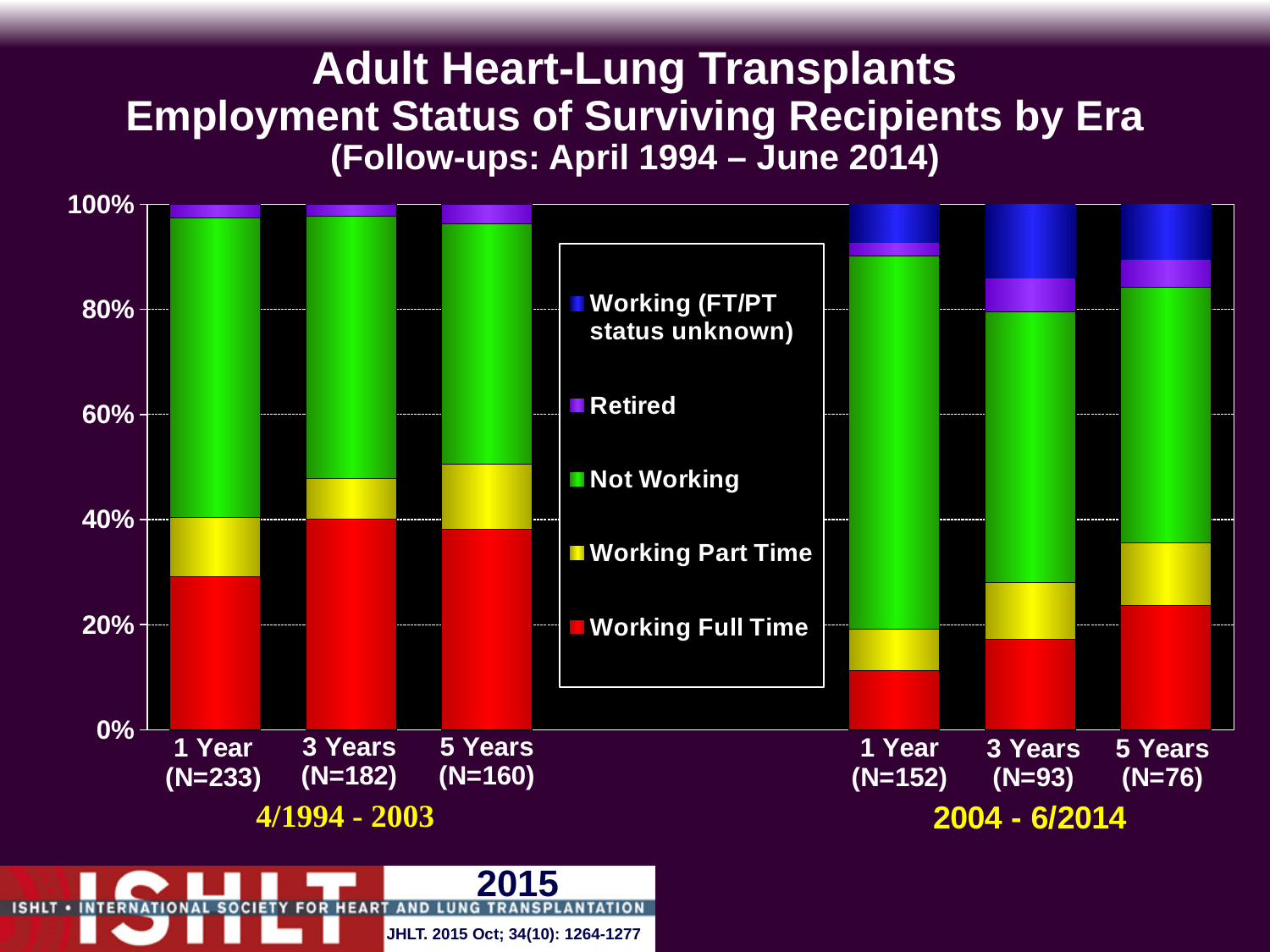
What kind of chart is shown on the slide? Stacked bar chart Is the Working Full Time share for 1 Year (N=233) in the 4/1994 - 2003 era greater or less than 20%? greater Which colour represents Working Full Time in the legend? Red What follow-up period is given in the chart title? April 1994 – June 2014 Which bar has the largest Not Working segment? 1 Year (N=152), 2004 - 6/2014 Which has the larger Working Full Time share: 1 Year (N=233) in 4/1994 - 2003 or 1 Year (N=152) in 2004 - 6/2014? 1 Year (N=233) in 4/1994 - 2003 Is the Working Full Time share for 3 Years (N=93) in the 2004 - 6/2014 era greater or less than 20%? less Is the Working Full Time share for 1 Year (N=152) in the 2004 - 6/2014 era greater or less than 20%? less Which bar has the smallest Working Full Time segment? 1 Year (N=152), 2004 - 6/2014 How many bars are plotted in total across both eras? 6 How many series does the legend list? 5 How many follow-up time points are shown for the 2004 - 6/2014 era? 3